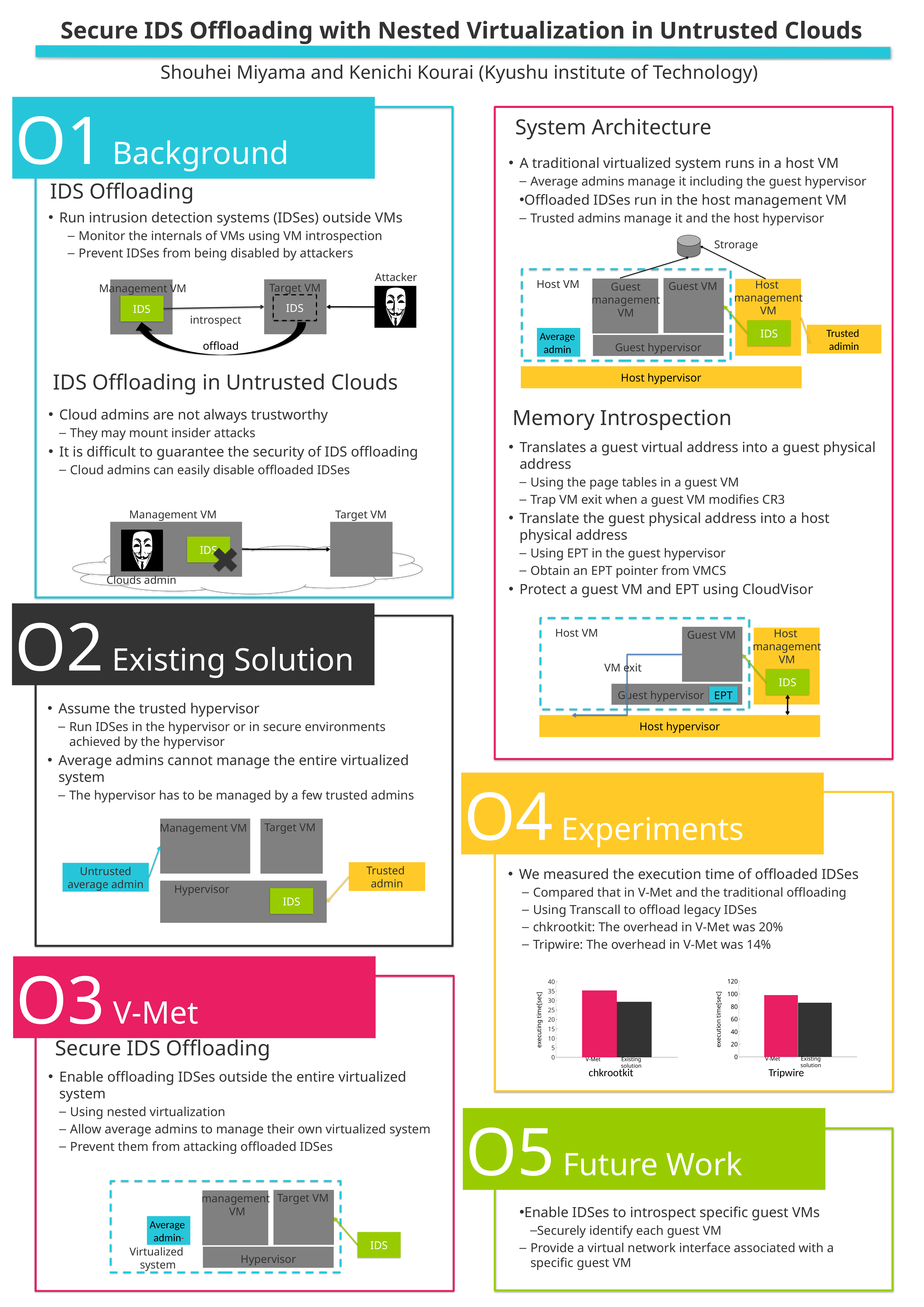
In the Tripwire chart, how many categories are shown on the x axis? 2 In the Tripwire chart, which category has the lowest execution time? Existing solution In the Tripwire chart, is the value for Existing solution greater or less than 100? less In the chkrootkit chart, which category has the higher execution time, V-Met or Existing solution? V-Met In the chkrootkit chart, what kind of chart is shown? bar chart In the Tripwire chart, is the value for V-Met greater or less than 80? greater In the Tripwire chart, which category has the highest execution time? V-Met In the chkrootkit chart, is the value for V-Met greater or less than 30? greater In the chkrootkit chart, what colour is the V-Met bar? pink In the chkrootkit chart, how many bars are plotted? 2 In the Tripwire chart, what is the label on the y axis? execution time[sec]